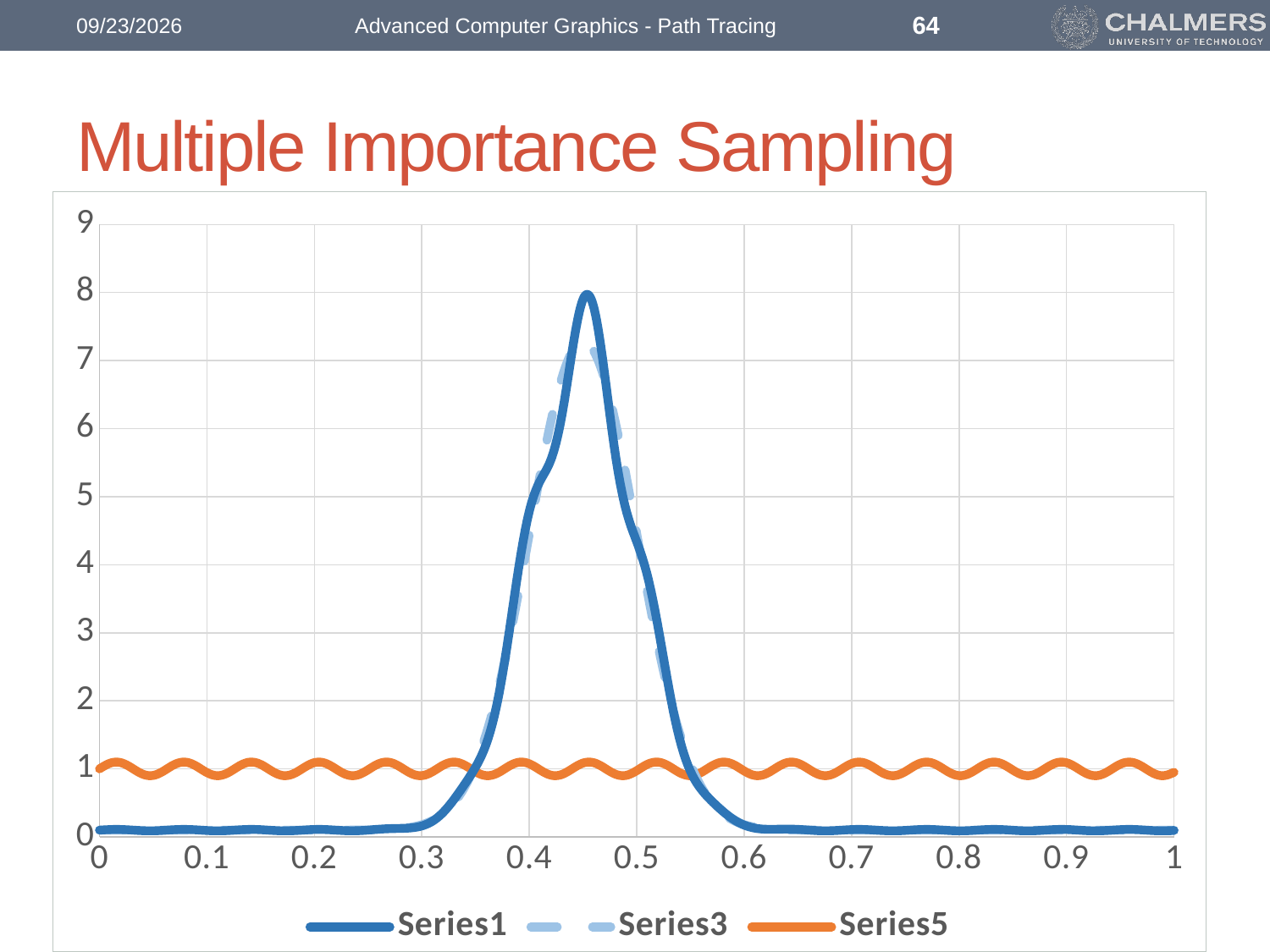
Is the value of Series1 at x = 0.1 greater or less than 1? less What kind of chart is shown on the slide? line chart Is the value of Series5 at x = 0.2 greater or less than 2? less Does Series1 rise or fall between x = 0.3 and x = 0.45? rise Does Series1 rise or fall between x = 0.5 and x = 0.6? fall What is the highest value labelled on the vertical axis? 9 Which series is drawn in orange? Series5 At x = 0.2, which series has the higher value, Series1 or Series5? Series5 Which series is drawn with a dashed line? Series3 How many series does the legend list? 3 Is the peak value of Series1 greater or less than 7? greater At x = 0.45, which series has the higher value, Series1 or Series5? Series1